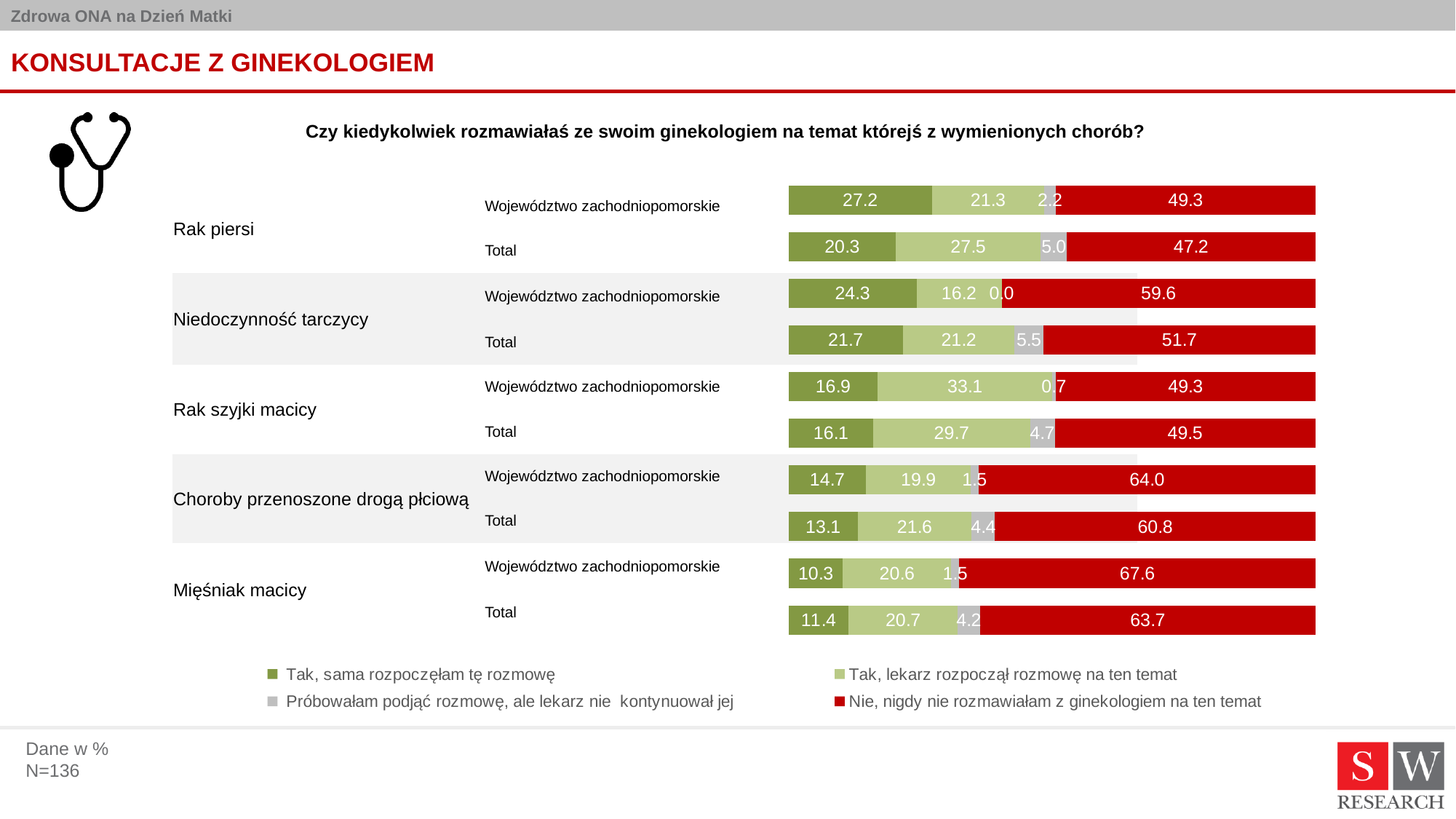
Which colour represents "Nie, nigdy nie rozmawiałam z ginekologiem na ten temat" in the chart? Red Which bar has the lowest value for "Tak, sama rozpoczęłam tę rozmowę"? Mięśniak macicy, Województwo zachodniopomorskie (10.3) What kind of chart is shown on the slide? Stacked bar chart What is the total of the stacked bar for Rak piersi (Total)? 100.0 For Mięśniak macicy (Total), what is the value for "Tak, sama rozpoczęłam tę rozmowę"? 11.4 For Rak piersi in Województwo zachodniopomorskie, what is the value for "Nie, nigdy nie rozmawiałam z ginekologiem na ten temat"? 49.3 For Rak szyjki macicy, which has the larger value for "Tak, lekarz rozpoczął rozmowę na ten temat": Województwo zachodniopomorskie or Total? Województwo zachodniopomorskie How many series does the legend list? 4 For Niedoczynność tarczycy, how much higher is the "Nie, nigdy nie rozmawiałam" value for Województwo zachodniopomorskie than for Total? 7.9 Which bar has the highest value for "Nie, nigdy nie rozmawiałam z ginekologiem na ten temat"? Mięśniak macicy, Województwo zachodniopomorskie (67.6) For Choroby przenoszone drogą płciową in Województwo zachodniopomorskie, what is the value for "Próbowałam podjąć rozmowę, ale lekarz nie kontynuował jej"? 1.5 How many diseases are listed in the chart? 5